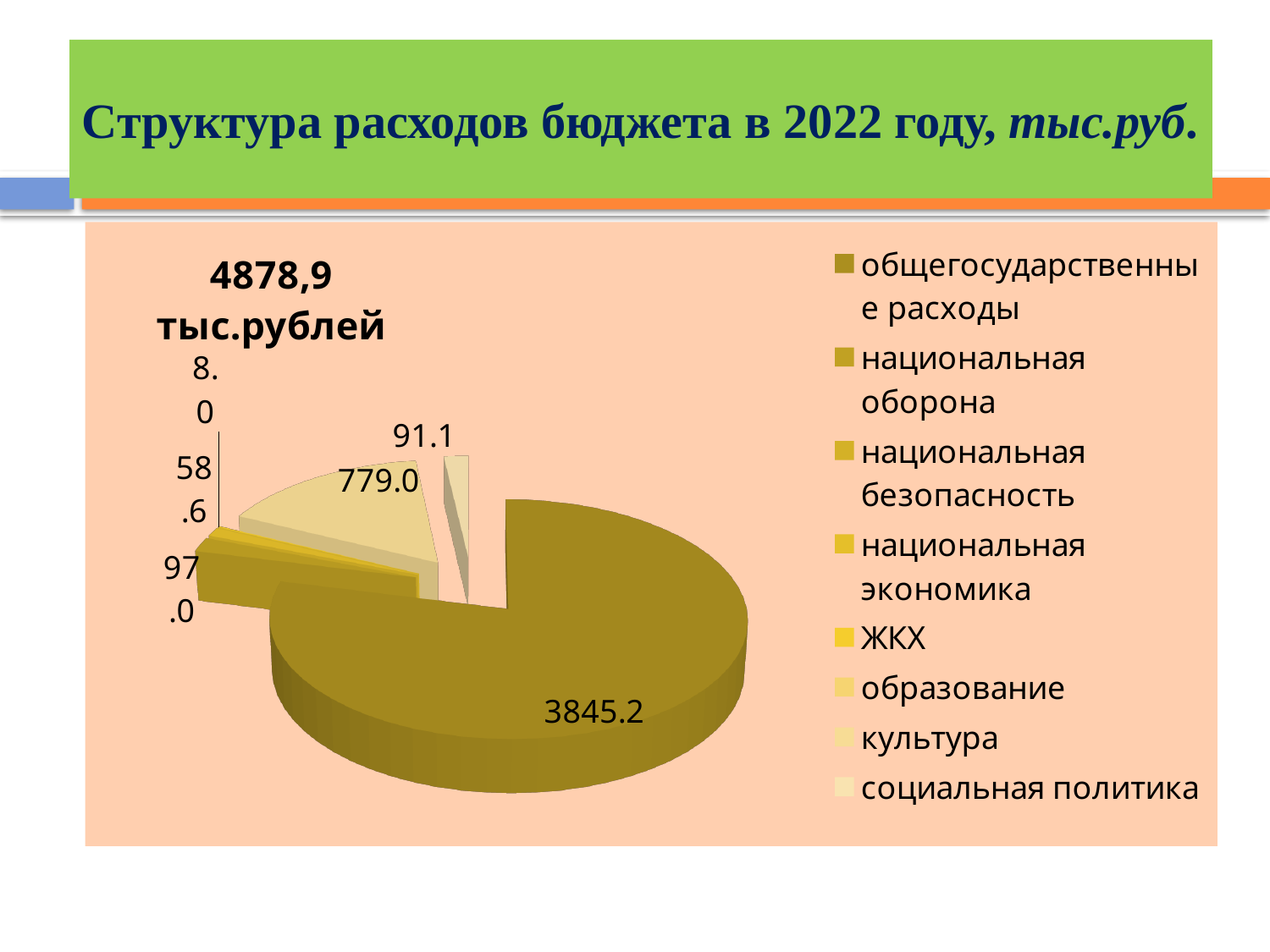
Which category has the largest slice of the pie? общегосударственные расходы What is the smallest data label value shown on the pie? 8.0 How many data labels are printed on the pie chart? 6 What kind of chart is shown on the slide? pie chart What is the difference between the slice labelled 3845.2 and the slice labelled 779.0? 3066.2 What is the value of the largest slice of the pie? 3845.2 Which is larger, the slice labelled 779.0 or the slice labelled 91.1? 779.0 How many categories does the legend list? 8 What total amount is shown above the pie chart? 4878,9 тыс.рублей What is the value for общегосударственные расходы? 3845.2 What is the title of the slide? Структура расходов бюджета в 2022 году, тыс.руб. What is the difference between the slices labelled 97.0 and 58.6? 38.4